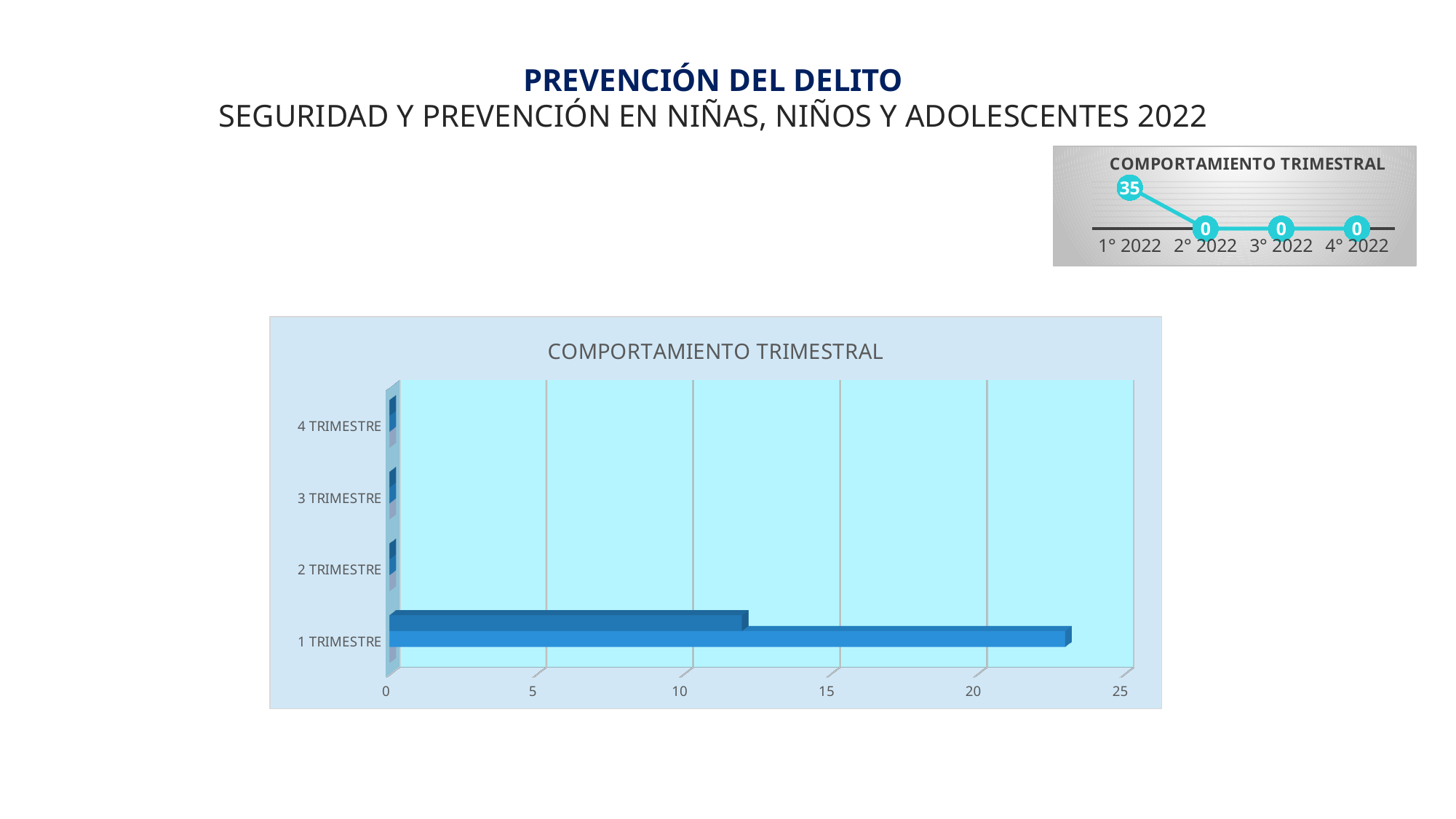
In the large bar chart, which category has the highest value? 1 TRIMESTRE What kind of chart is the large chart in the lower part of the slide? bar chart In the small line chart at the top right, how many periods are plotted? 4 In the small line chart at the top right, do the values rise or fall from 1° 2022 to 2° 2022? fall In the small line chart at the top right, what is the value for 1° 2022? 35 In the small line chart at the top right, what is the value for 3° 2022? 0 What kind of chart is the small chart at the top right? line chart In the large bar chart, is the value of the longer bar for 1 TRIMESTRE greater or less than 20? greater In the small line chart at the top right, which period has the highest value? 1° 2022 In the small line chart at the top right, what is the difference between the values for 1° 2022 and 2° 2022? 35 In the large bar chart, how many categories are shown on the vertical axis? 4 In the large bar chart, is the value of the shorter bar for 1 TRIMESTRE greater or less than 15? less